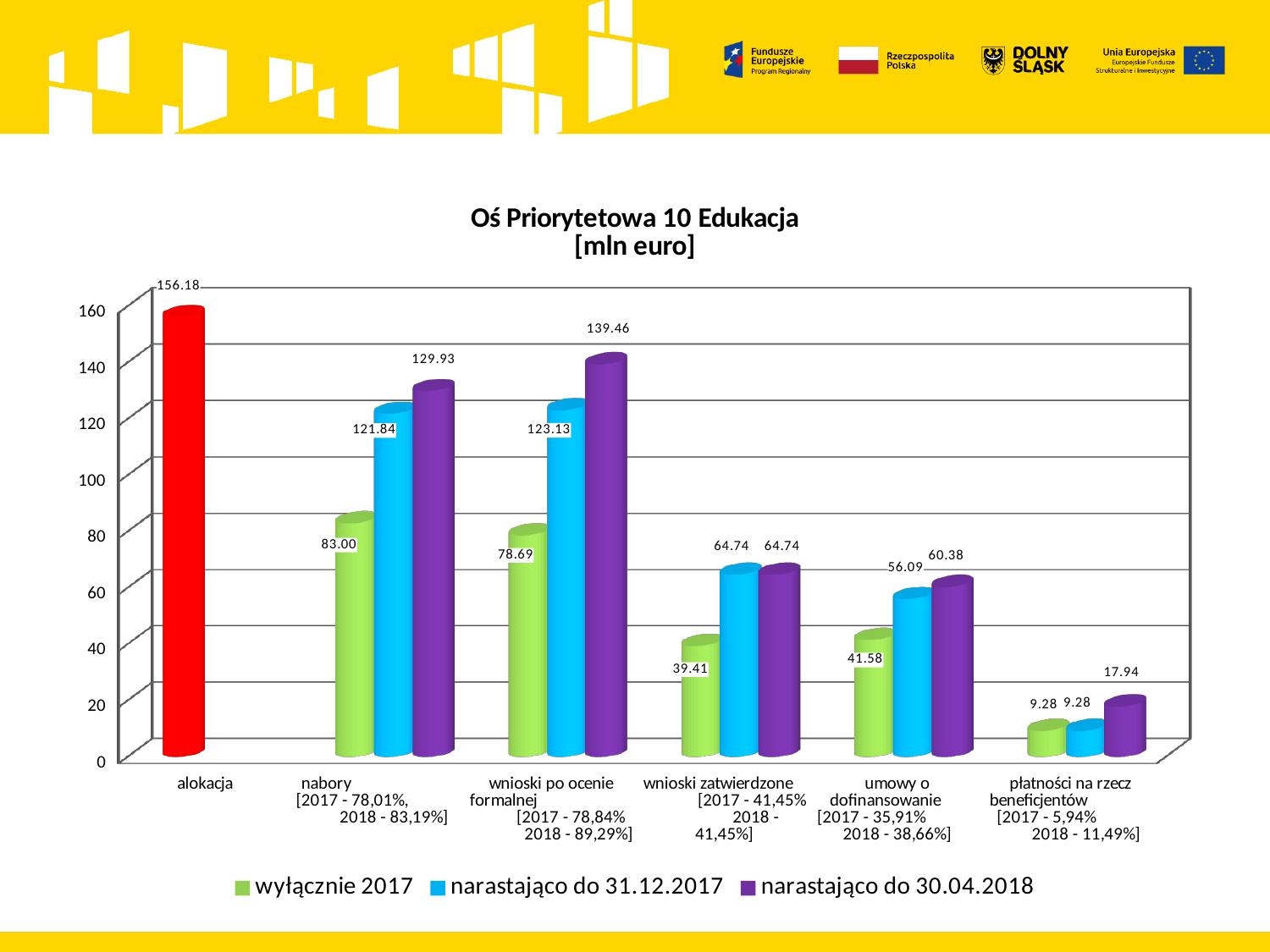
What is the value for 'nabory' in the 'narastająco do 30.04.2018' series? 129.93 What unit is given in the chart title? mln euro How many series does the legend list? 3 Which category has the lowest value in the 'wyłącznie 2017' series? płatności na rzecz beneficjentów What kind of chart is shown on the slide? bar chart Which is larger for 'nabory': the 'wyłącznie 2017' value or the 'narastająco do 31.12.2017' value? narastająco do 31.12.2017 What is the value for 'umowy o dofinansowanie' in the 'narastająco do 31.12.2017' series? 56.09 What is the difference between the 'narastająco do 30.04.2018' and 'narastająco do 31.12.2017' values for 'wnioski po ocenie formalnej'? 16.33 What is the value for 'wnioski po ocenie formalnej' in the 'wyłącznie 2017' series? 78.69 How many categories are shown on the x axis? 6 Which category has the highest value in the 'narastająco do 30.04.2018' series? wnioski po ocenie formalnej What is the value of the alokacja bar? 156.18